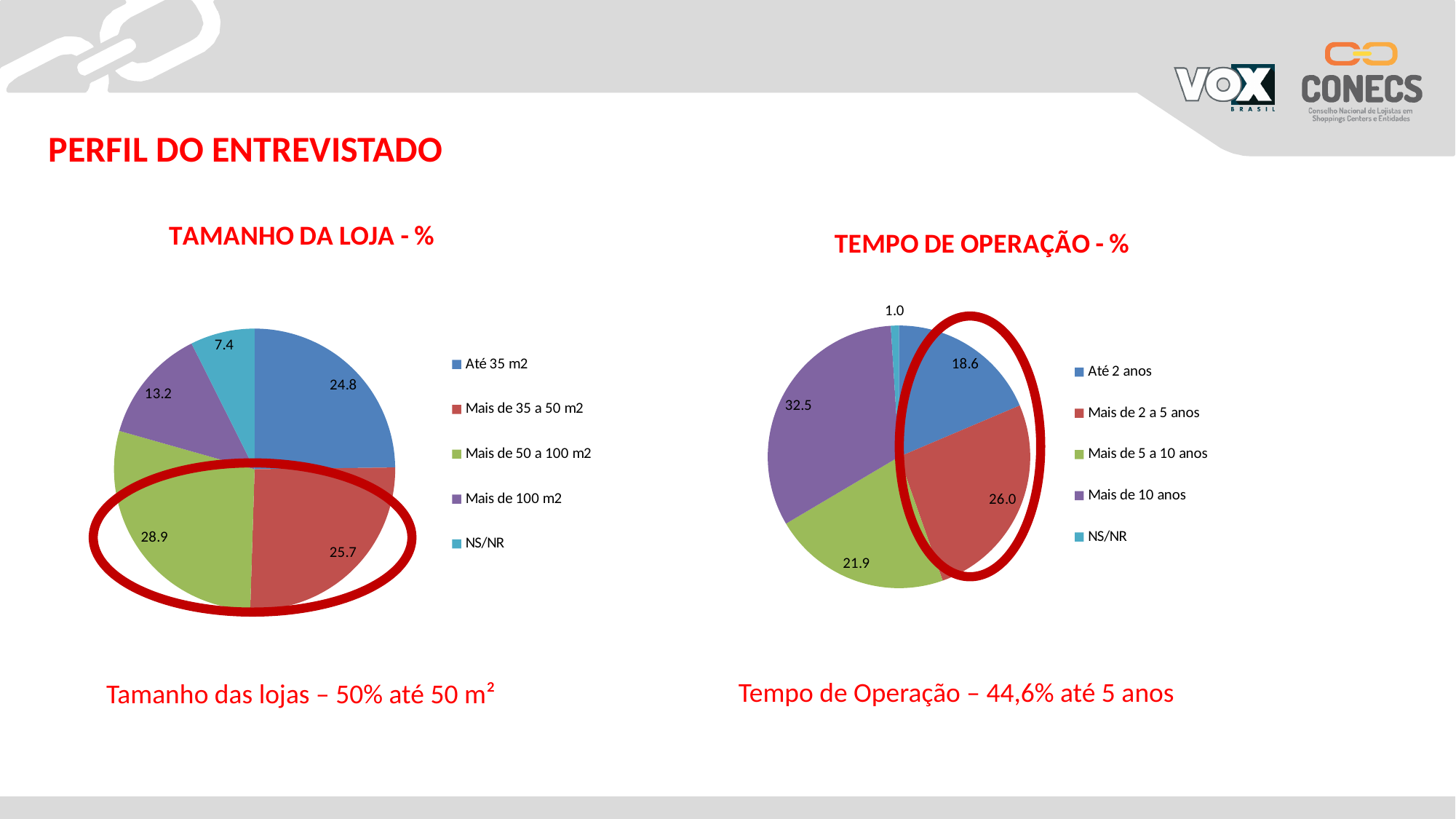
What type of chart is the 'TEMPO DE OPERAÇÃO - %' chart? Pie chart In the 'TEMPO DE OPERAÇÃO - %' chart, what is the value for 'Até 2 anos'? 18.6 In the 'TAMANHO DA LOJA - %' chart, which category has the largest slice? Mais de 50 a 100 m2 In the 'TEMPO DE OPERAÇÃO - %' chart, what is the difference between 'Mais de 10 anos' and 'Mais de 5 a 10 anos'? 10.6 In the 'TAMANHO DA LOJA - %' chart, what is the value for 'NS/NR'? 7.4 In the 'TAMANHO DA LOJA - %' chart, how many categories are shown? 5 In the 'TEMPO DE OPERAÇÃO - %' chart, what is the value for 'Mais de 10 anos'? 32.5 In the 'TAMANHO DA LOJA - %' chart, what is the difference between 'Mais de 35 a 50 m2' and 'Até 35 m2'? 0.9 In the 'TEMPO DE OPERAÇÃO - %' chart, which category has the smallest slice? NS/NR In the 'TAMANHO DA LOJA - %' chart, which category has the smallest slice? NS/NR In the 'TAMANHO DA LOJA - %' chart, what is the value for 'Mais de 50 a 100 m2'? 28.9 In the 'TEMPO DE OPERAÇÃO - %' chart, which is larger: 'Mais de 2 a 5 anos' or 'Mais de 5 a 10 anos'? Mais de 2 a 5 anos